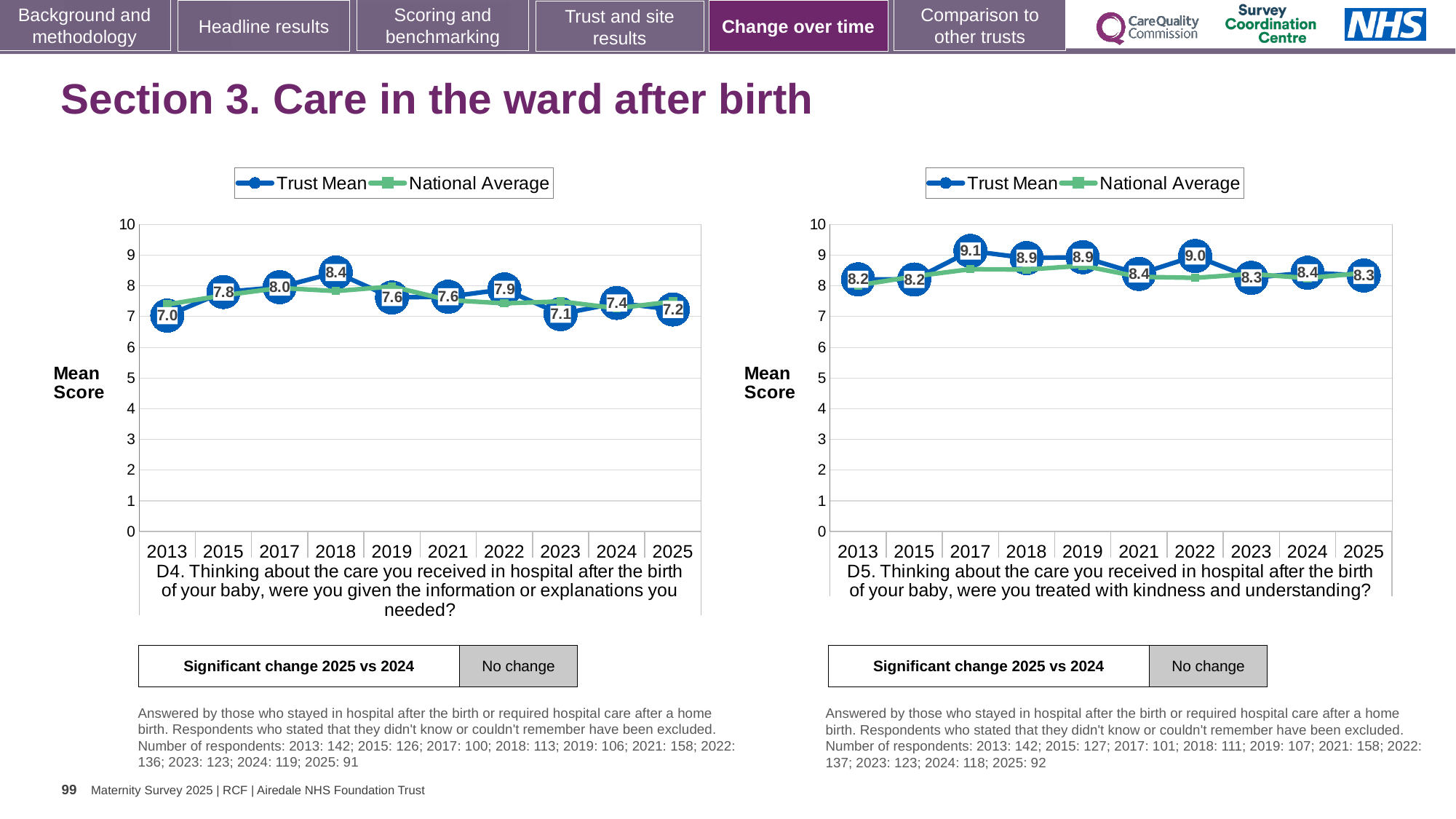
In the D4 chart on the left, which year has the lowest Trust Mean? 2013 In the D4 chart on the left, which year has the highest Trust Mean? 2018 How many series does the legend of the D4 chart on the left list? 2 In the D4 chart on the left, what is the difference between the Trust Mean for 2018 and the Trust Mean for 2023? 1.3 In the D4 chart on the left, what is the Trust Mean for 2025? 7.2 In the D5 chart on the right, what is the difference between the Trust Mean for 2025 and the Trust Mean for 2024? 0.1 In the D4 chart on the left, what is the Trust Mean for 2013? 7.0 How many years are shown on the x axis of the D5 chart on the right? 10 What kind of chart is the D4 chart on the left? Line chart In the D5 chart on the right, is the Trust Mean for 2022 larger than the Trust Mean for 2021? Yes In the D5 chart on the right, which year has the highest Trust Mean? 2017 In the D5 chart on the right, what is the Trust Mean for 2017? 9.1